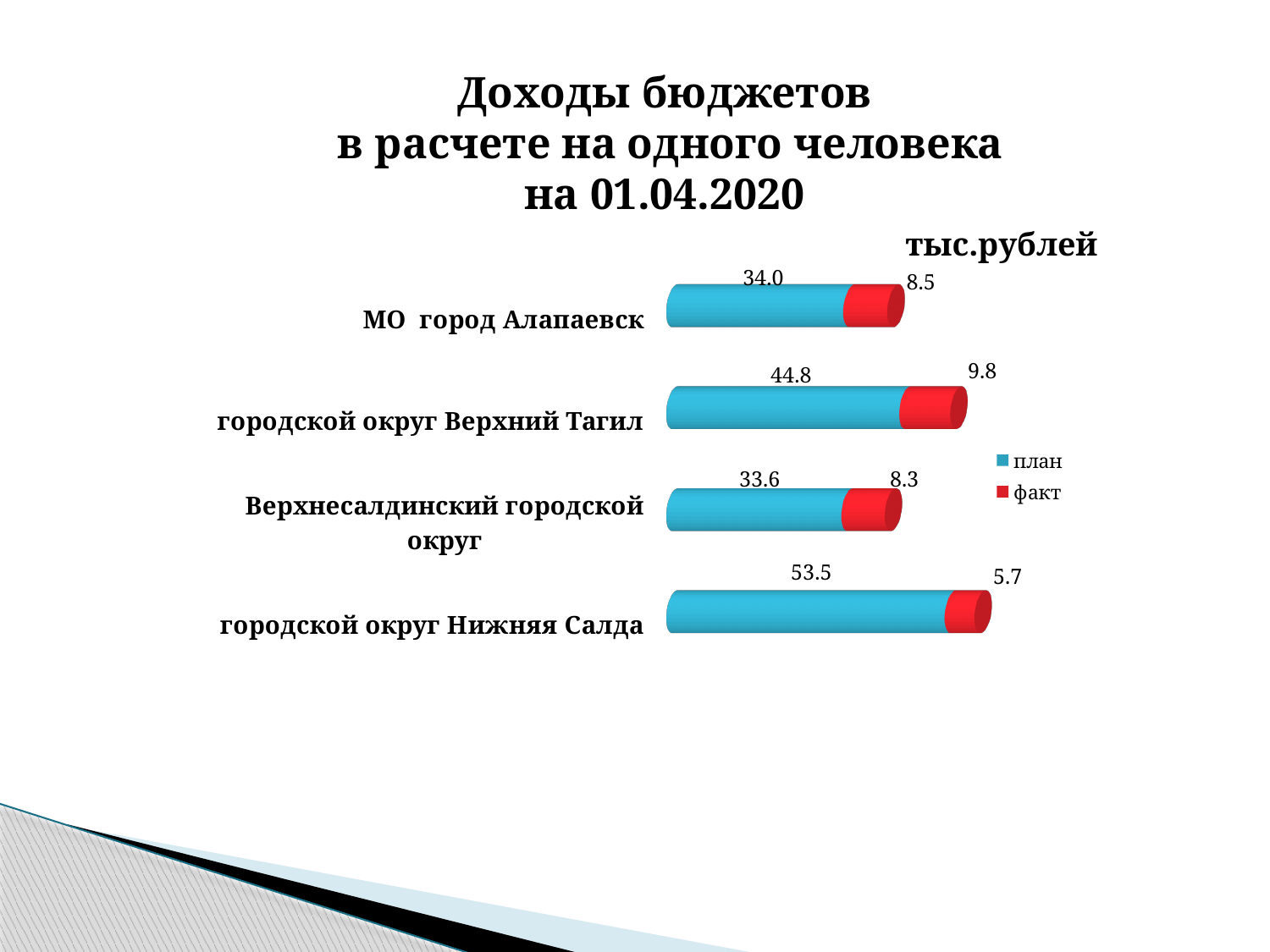
What is the факт value for Верхнесалдинский городской округ? 8.3 Which category has the lowest факт value? городской округ Нижняя Салда Which category has the highest план value? городской округ Нижняя Салда What is the факт value for городской округ Верхний Тагил? 9.8 Which is larger, the факт value for МО город Алапаевск or the факт value for городской округ Верхний Тагил? городской округ Верхний Тагил How many categories are shown in the chart? 4 What is the план value for городской округ Нижняя Салда? 53.5 What kind of chart is shown on the slide? bar chart How many series does the legend list? 2 What is the difference between the план and факт values for городской округ Верхний Тагил? 35.0 What is the план value for МО город Алапаевск? 34.0 What unit is indicated above the chart? тыс.рублей